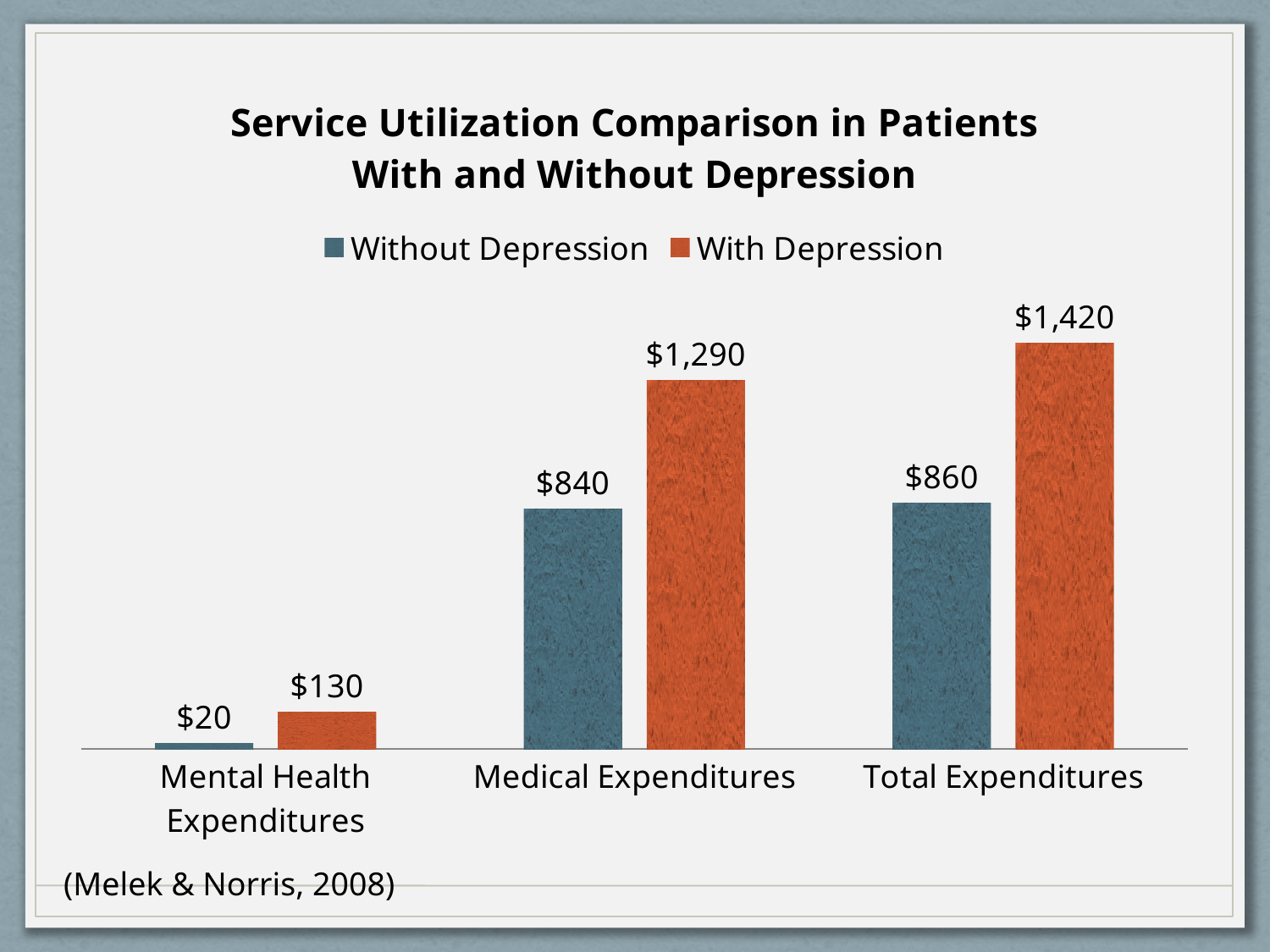
Which category has the lowest value for the Without Depression series? Mental Health Expenditures How many series does the legend list? 2 Which category has the highest value for the With Depression series? Total Expenditures What kind of chart is shown on the slide? Bar chart What is the value for Without Depression in the Mental Health Expenditures category? $20 What is the value for With Depression in the Total Expenditures category? $1,420 What is the value for With Depression in the Medical Expenditures category? $1,290 Which is larger for Mental Health Expenditures: the Without Depression value or the With Depression value? With Depression What is the value for Without Depression in the Total Expenditures category? $860 How many categories are shown on the x axis? 3 What is the difference between the With Depression and Without Depression values for Medical Expenditures? $450 What is the difference between the With Depression and Without Depression values for Total Expenditures? $560